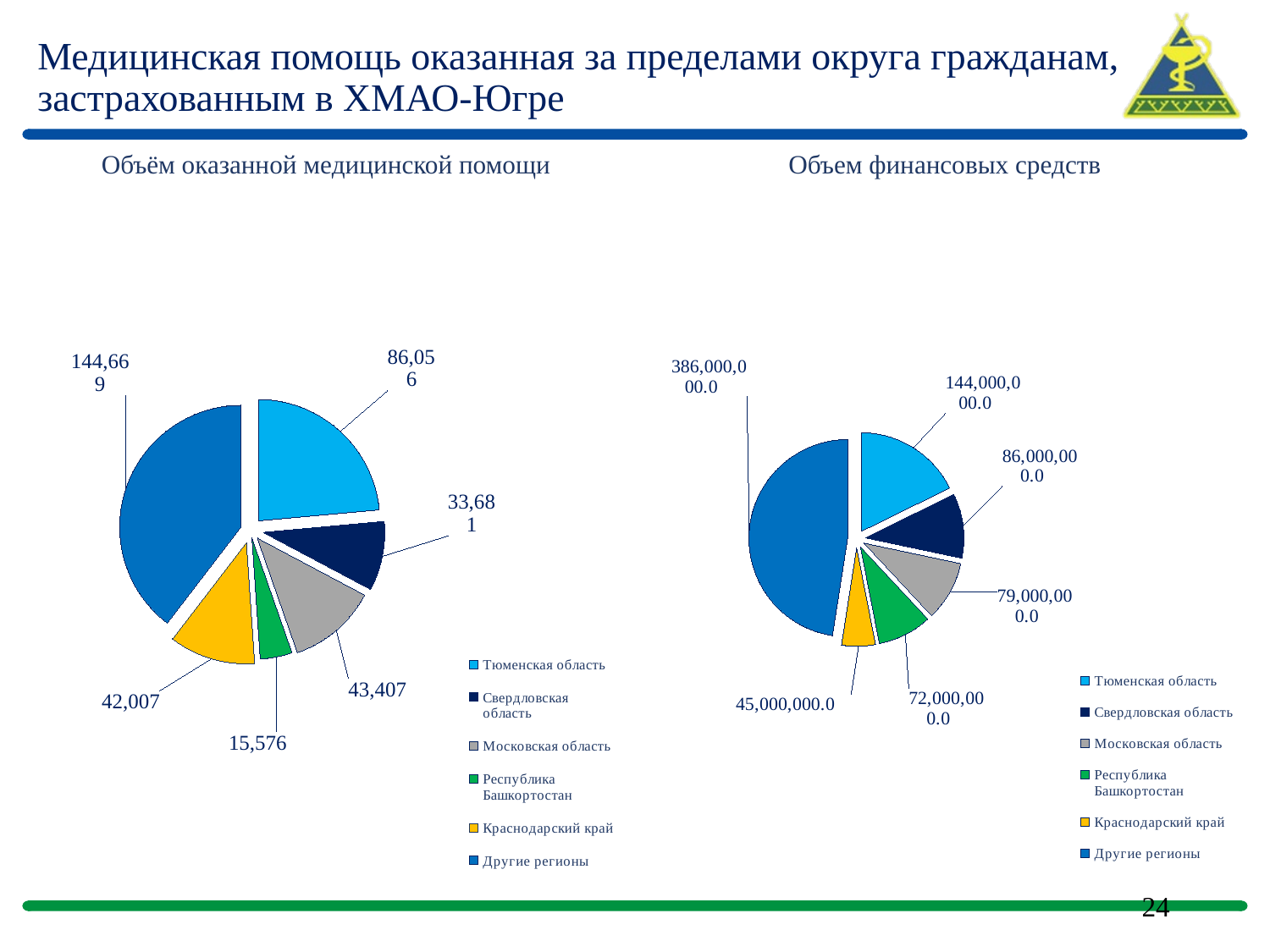
How many categories does the legend of the right pie chart (Объем финансовых средств) list? 6 In the left pie chart (Объём оказанной медицинской помощи), what is the value for Тюменская область? 86,056 In the right pie chart (Объем финансовых средств), what is the difference between the values for Тюменская область and Свердловская область? 58,000,000.0 In the right pie chart (Объем финансовых средств), what is the value for Краснодарский край? 45,000,000.0 In the right pie chart (Объем финансовых средств), what is the value for Другие регионы? 386,000,000.0 In the left pie chart (Объём оказанной медицинской помощи), which category has the smallest slice? Республика Башкортостан In the left pie chart (Объём оказанной медицинской помощи), which is larger: Свердловская область or Краснодарский край? Краснодарский край In the left pie chart (Объём оказанной медицинской помощи), which category has the largest slice? Другие регионы In the right pie chart (Объем финансовых средств), which category has the smallest slice? Краснодарский край In the left pie chart (Объём оказанной медицинской помощи), what is the difference between the values for Тюменская область and Московская область? 42,649 What type of chart is used for Объём оказанной медицинской помощи on the left? Pie chart In the left pie chart (Объём оказанной медицинской помощи), what is the value for Республика Башкортостан? 15,576